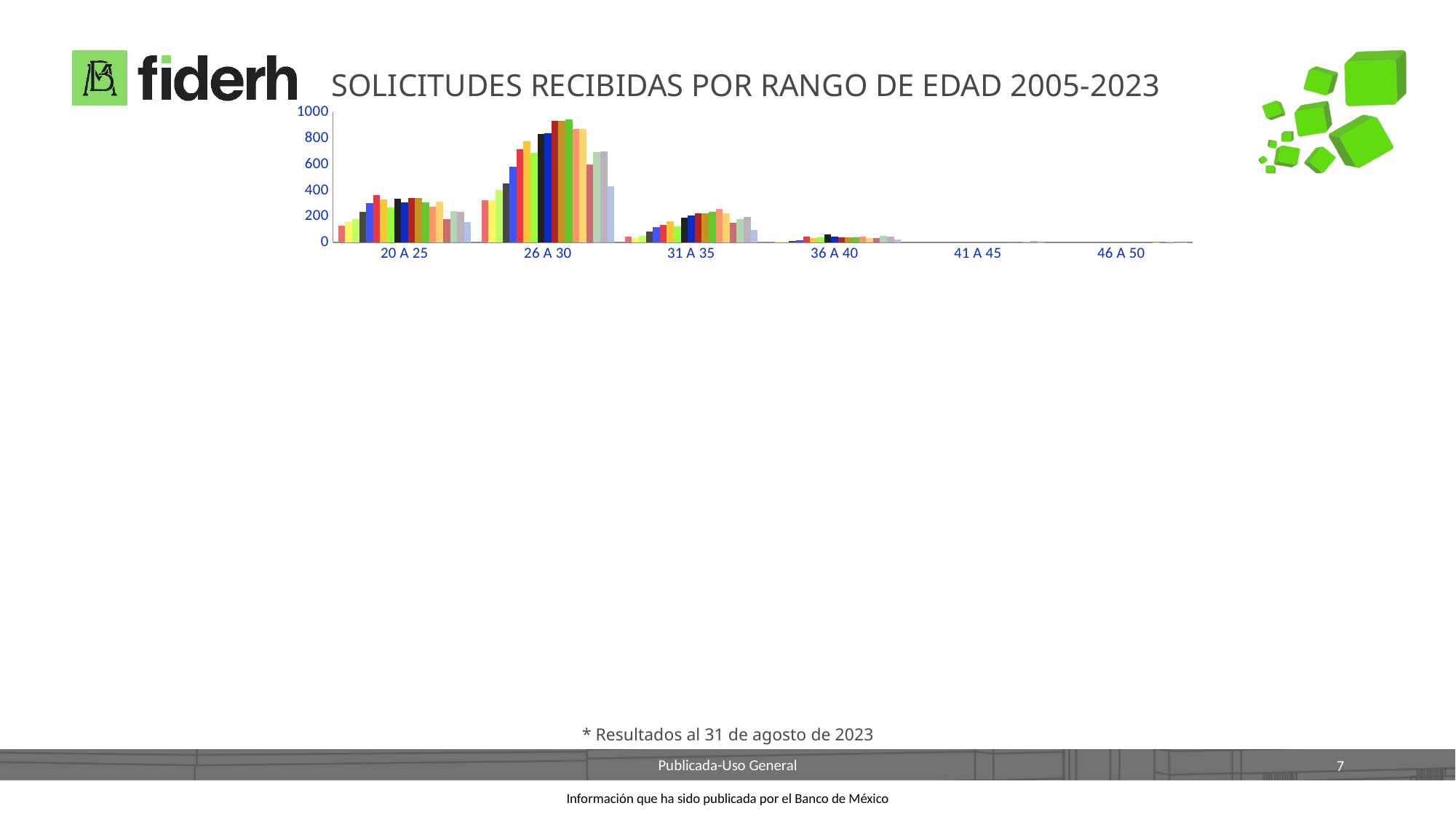
Is the tallest bar in the 31 A 35 group greater or less than 400? less How many age-range categories are shown on the x axis? 6 What kind of chart is shown on the slide? bar chart Which group has higher bars, 26 A 30 or 31 A 35? 26 A 30 Is the tallest bar in the 36 A 40 group greater or less than 200? less What is the highest value shown on the vertical axis? 1000 Which age range has the tallest bars? 26 A 30 Is the tallest bar in the 20 A 25 group greater or less than 600? less Which group has higher bars, 20 A 25 or 36 A 40? 20 A 25 What is the title of the chart? SOLICITUDES RECIBIDAS POR RANGO DE EDAD 2005-2023 Do the bar heights rise or fall along the x axis from 26 A 30 to 46 A 50? fall